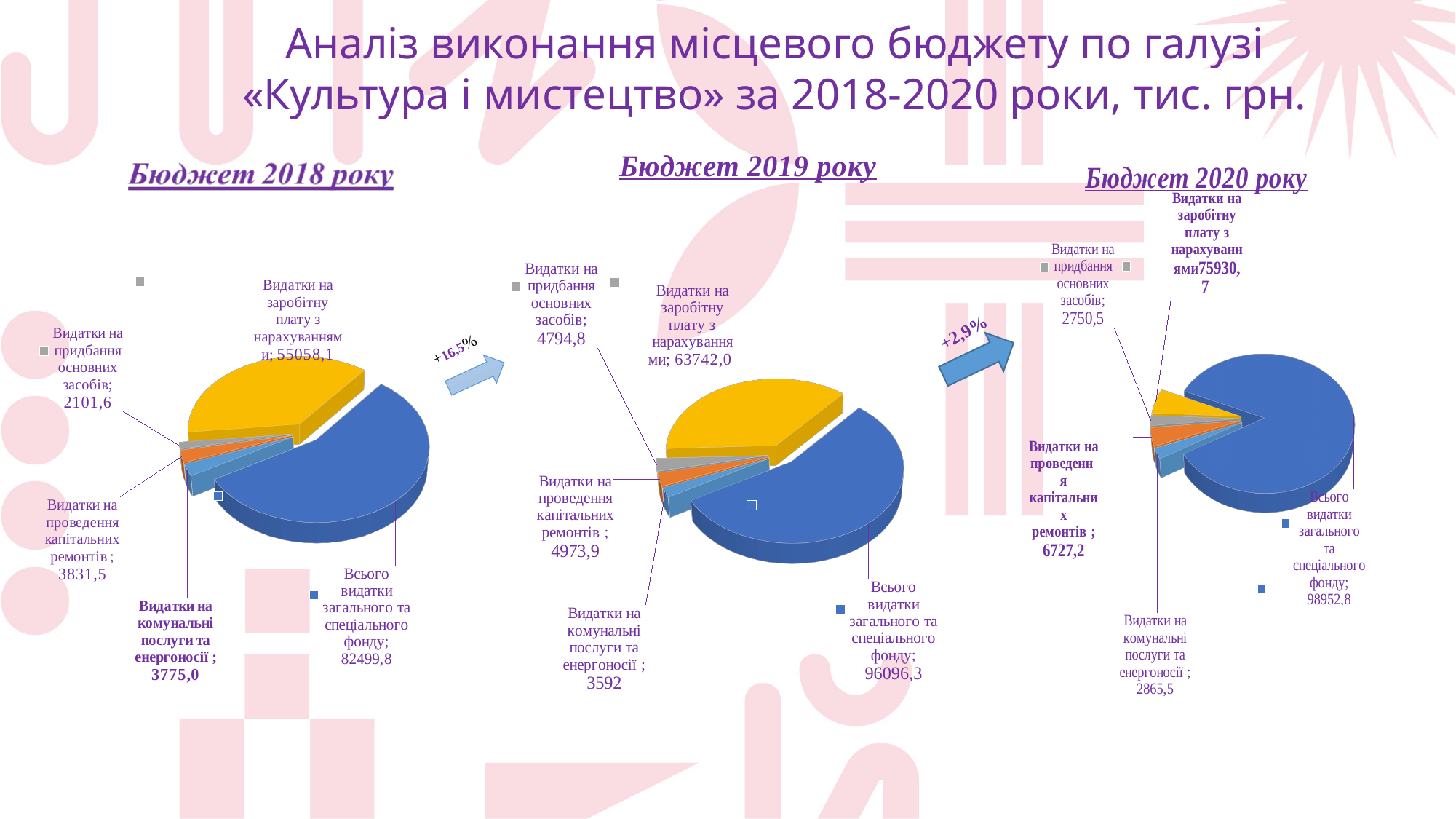
How many slices does the 'Бюджет 2019 року' pie chart have? 5 In the 'Бюджет 2018 року' chart, which category has the largest value? Всього видатки загального та спеціального фонду In the 'Бюджет 2018 року' chart, what is the value for 'Видатки на заробітну плату з нарахуваннями'? 55058,1 In the 'Бюджет 2020 року' chart, which is larger: 'Видатки на проведення капітальних ремонтів' or 'Видатки на придбання основних засобів'? Видатки на проведення капітальних ремонтів What percentage change is shown on the arrow between the 'Бюджет 2018 року' and 'Бюджет 2019 року' charts? +16,5% In the 'Бюджет 2020 року' chart, which category has the smallest value? Видатки на придбання основних засобів What type of chart is used for the 'Бюджет 2018 року' chart? pie chart In the 'Бюджет 2019 року' chart, what is the value for 'Видатки на проведення капітальних ремонтів'? 4973,9 In the 'Бюджет 2019 року' chart, what is the difference between 'Видатки на проведення капітальних ремонтів' and 'Видатки на комунальні послуги та енергоносії'? 1381,9 In the 'Бюджет 2018 року' chart, what is the value for 'Видатки на придбання основних засобів'? 2101,6 In the 'Бюджет 2020 року' chart, what is the value for 'Видатки на комунальні послуги та енергоносії'? 2865,5 In the 'Бюджет 2019 року' chart, what is the value for 'Всього видатки загального та спеціального фонду'? 96096,3